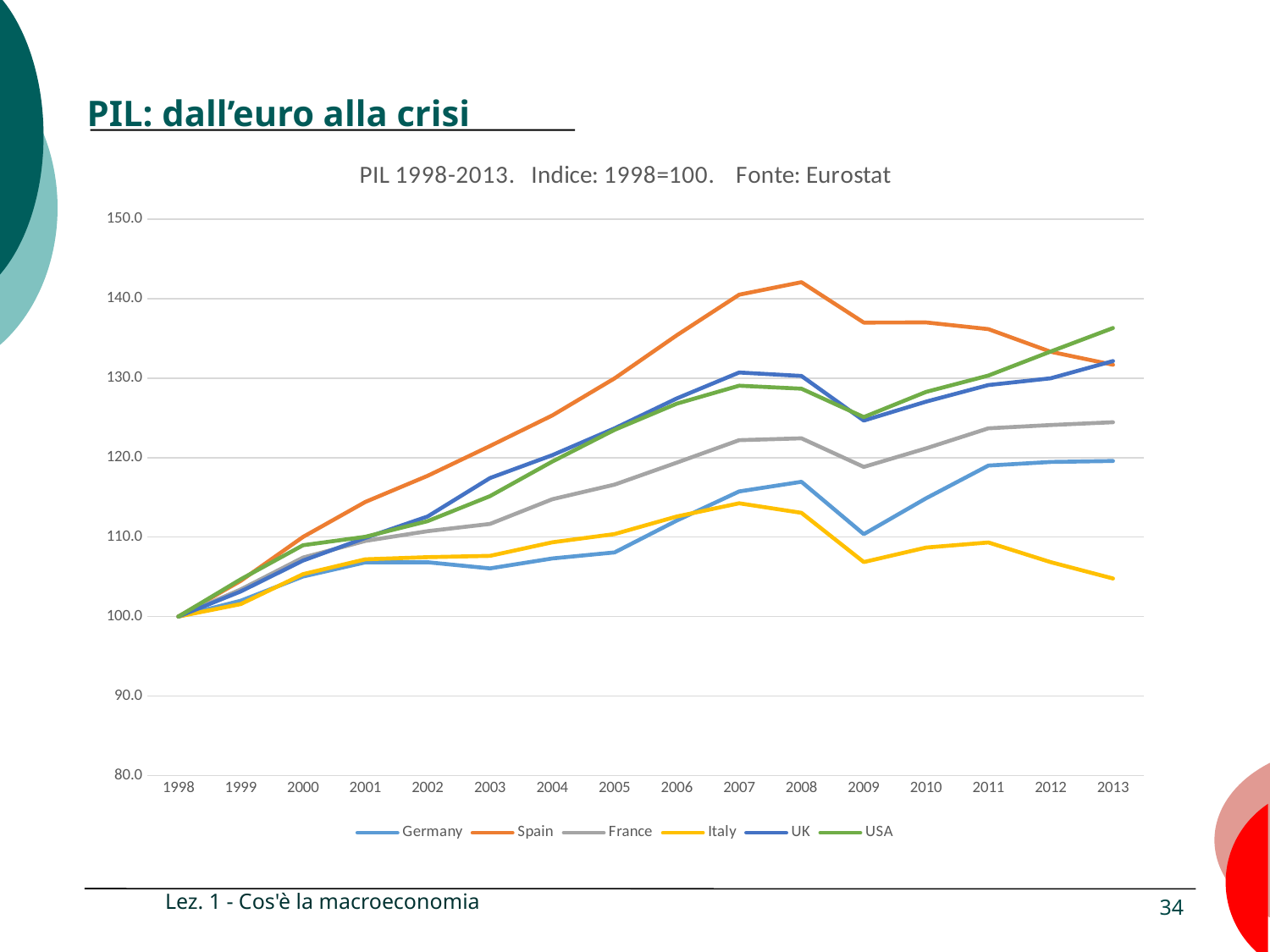
Which country has the lowest index value in 2013? Italy Does the value for Italy rise or fall from 2011 to 2013? fall Is the value for Spain in 2008 greater or less than 140.0? greater Which country has the highest index value in 2013? USA Which is larger in 2007, the value for Spain or the value for Italy? Spain Which country has the highest index value in 2008? Spain Is the value for Italy in 2013 greater or less than 110.0? less What is the title of the chart? PIL 1998-2013. Indice: 1998=100. Fonte: Eurostat What kind of chart is shown on the slide? line chart What is the index value for Germany in 1998? 100.0 How many series does the legend list? 6 How many years are shown on the x axis? 16